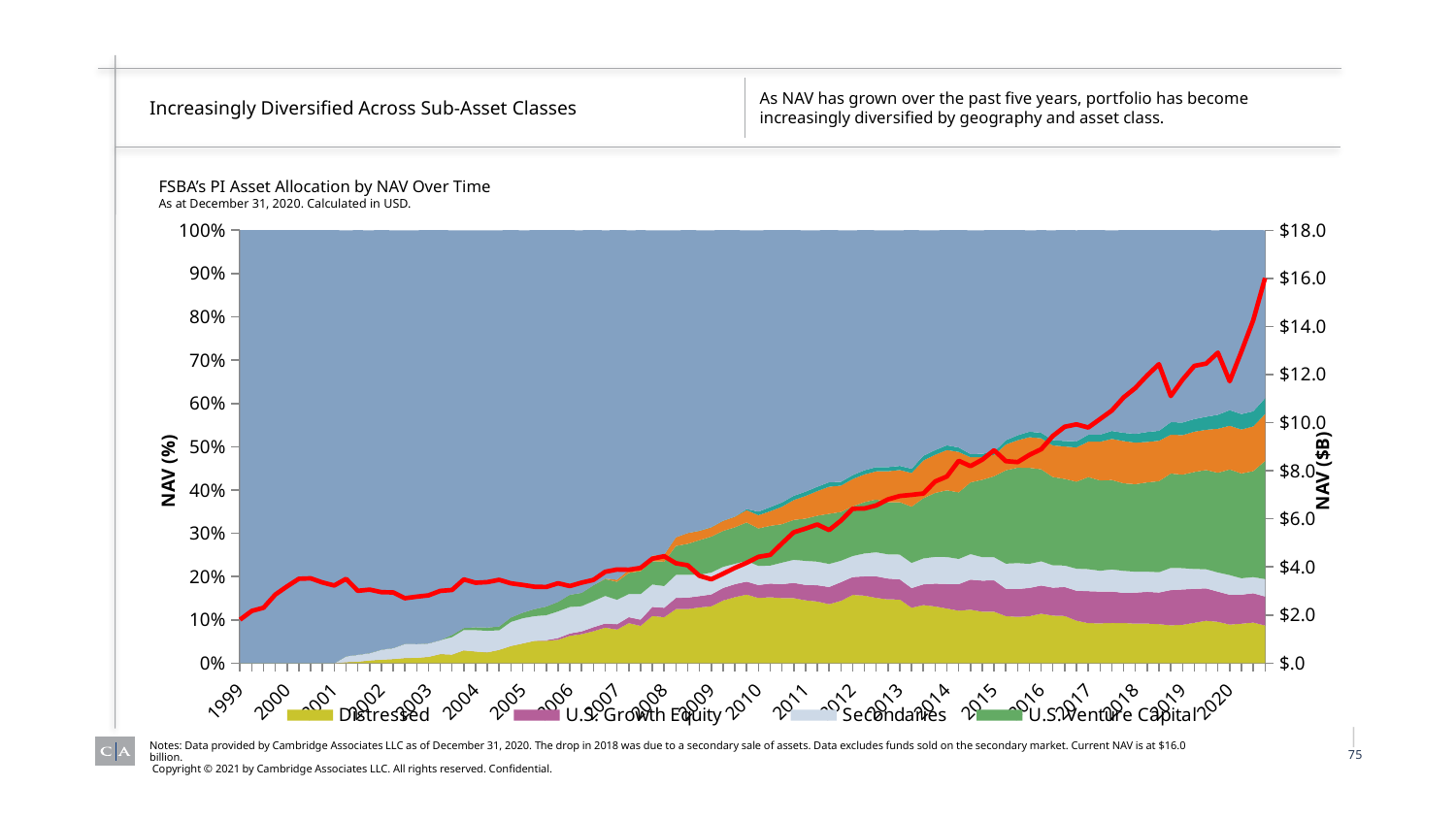
What is the label of the left vertical axis? NAV (%) Is the value of the red NAV ($B) line at the end of 2020 greater or less than $14.0? greater Is the Distressed share of NAV at 2010 greater or less than 10%? greater What kind of chart is shown on the slide? stacked area chart with a line Does the red NAV ($B) line generally rise or fall from 1999 to 2020? rise What is the title of the chart on the slide? FSBA's PI Asset Allocation by NAV Over Time Is the red NAV ($B) line higher at 2020 or at 2005? 2020 In which year does the red NAV ($B) line reach its highest value? 2020 How many years are labeled along the x axis? 22 Is the value of the red NAV ($B) line at 2018 greater or less than $10.0? greater